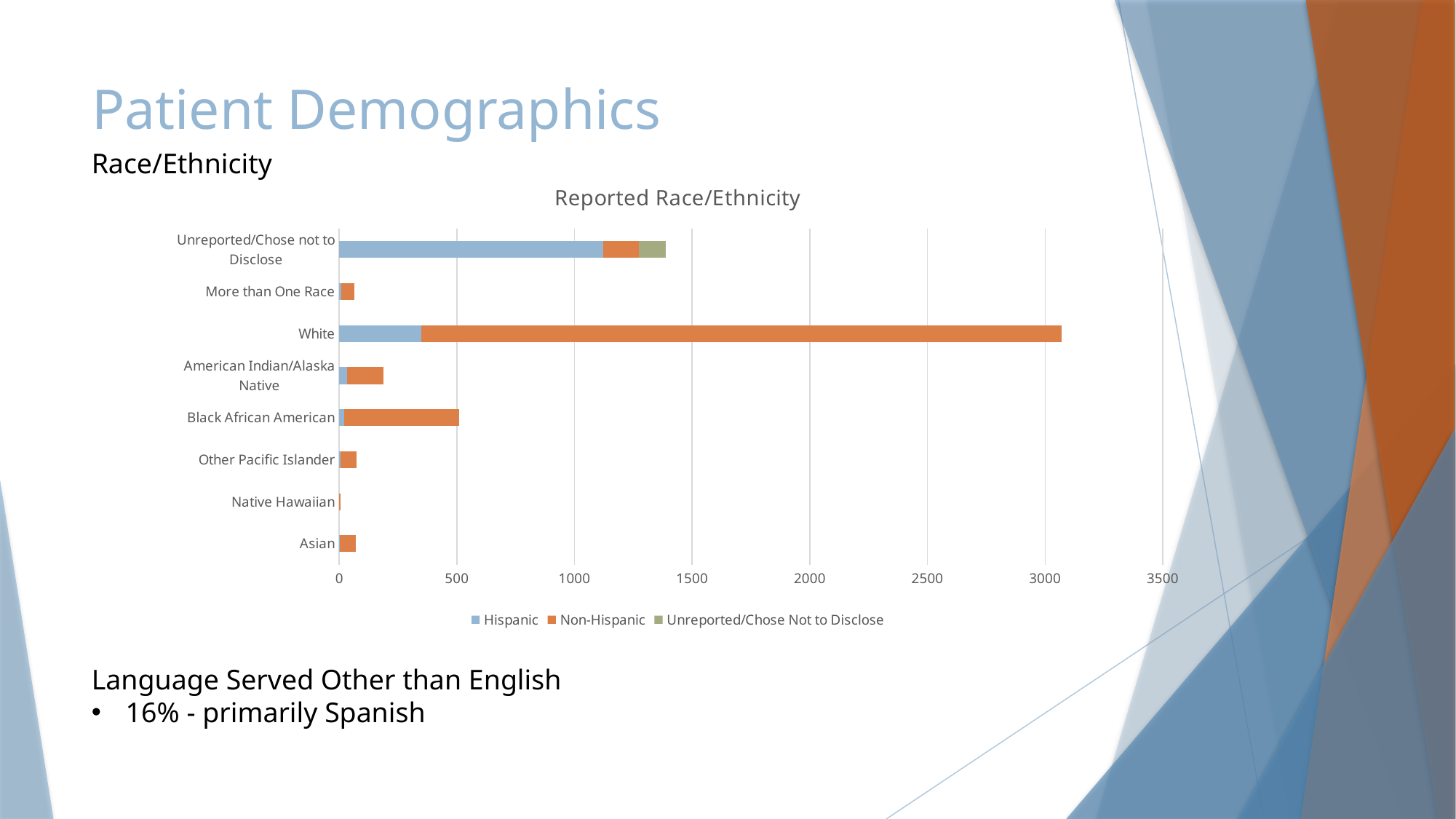
Which has a larger total bar, Black African American or American Indian/Alaska Native? Black African American Which category has the longest total bar? White What kind of chart is shown on the slide? Stacked bar chart What is the title of the chart? Reported Race/Ethnicity Which has a larger total bar, White or Unreported/Chose not to Disclose? White Is the total value for Unreported/Chose not to Disclose greater or less than 1500? less How many series does the legend list? 3 How many race/ethnicity categories are plotted on the chart? 8 Is the total value for American Indian/Alaska Native greater or less than 500? less Is the total value for White greater or less than 2500? greater Which category has the shortest total bar? Native Hawaiian Which series is shown in orange in the legend? Non-Hispanic